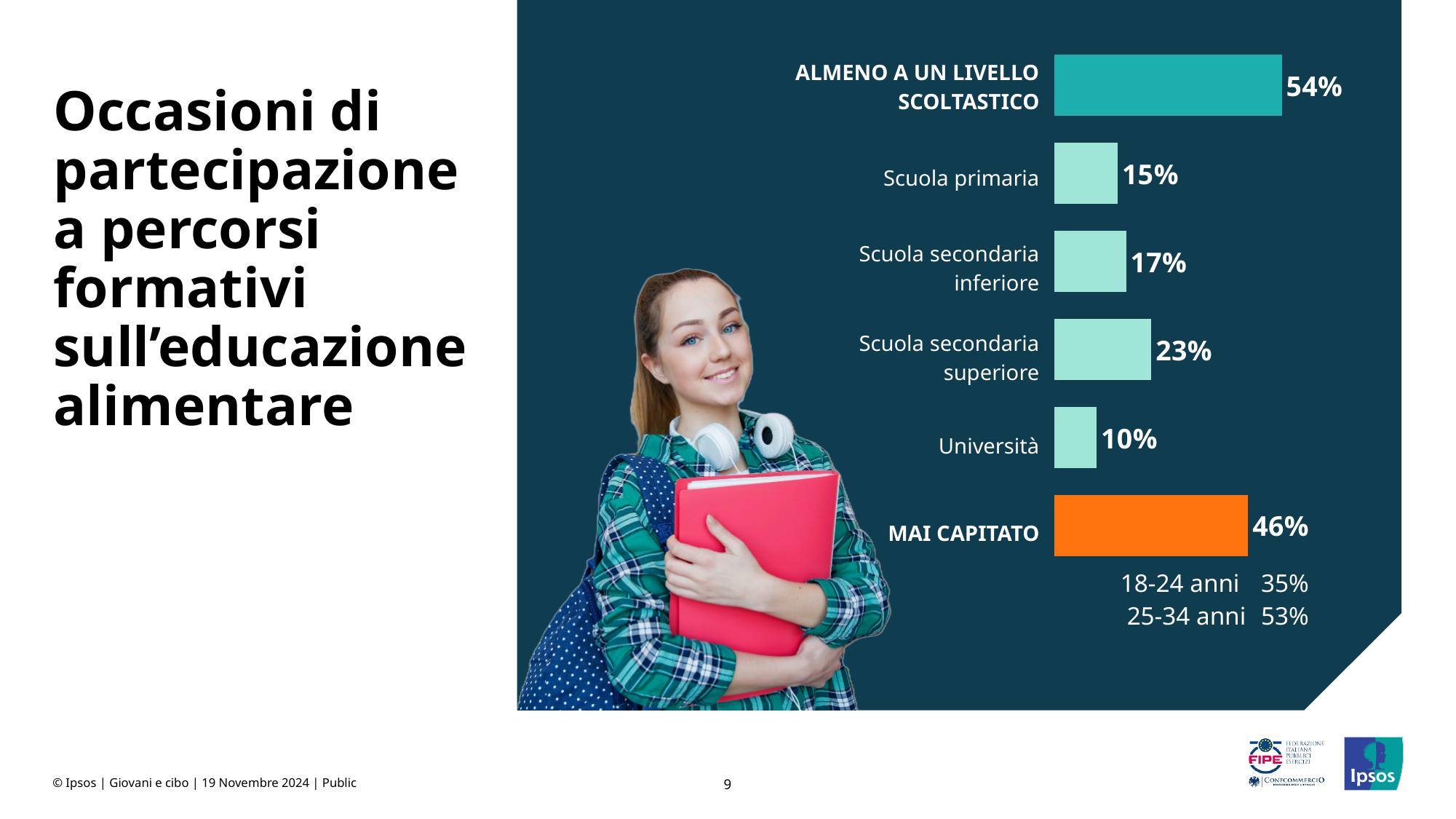
Which is larger, Scuola primaria or Scuola secondaria inferiore? Scuola secondaria inferiore Which category has the highest value? ALMENO A UN LIVELLO SCOLTASTICO What is the value for Università? 10% How many bars are shown in the chart? 6 What is the value for MAI CAPITATO? 46% Which category has the lowest value? Università What is the difference between Scuola secondaria superiore and Scuola secondaria inferiore? 6% What is the difference between ALMENO A UN LIVELLO SCOLTASTICO and MAI CAPITATO? 8% What is the value for Scuola primaria? 15% What colour is the MAI CAPITATO bar? Orange What kind of chart is shown on the slide? Bar chart What is the value for Scuola secondaria superiore? 23%